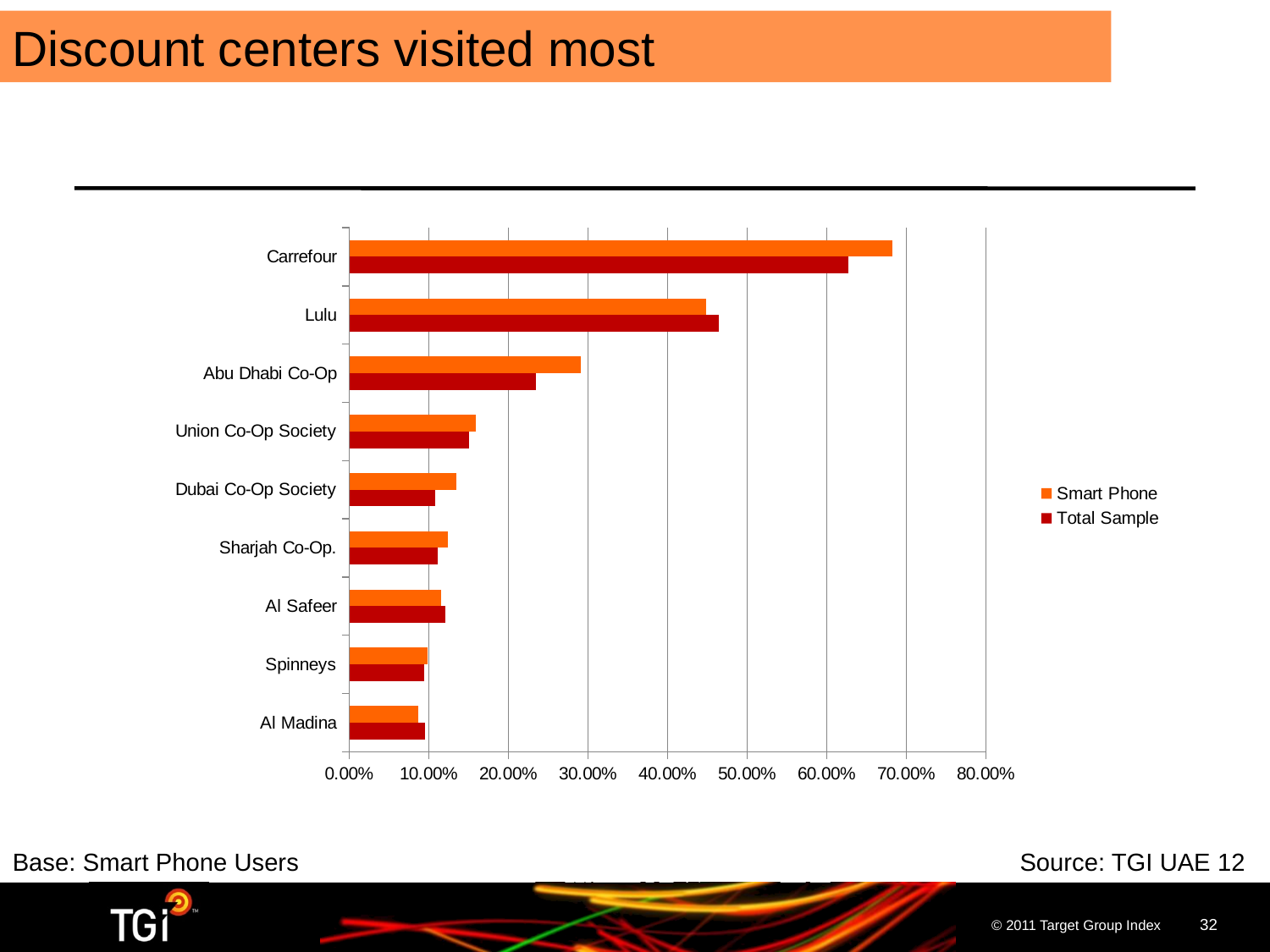
Is the Smart Phone value for Lulu greater or less than 50.00%? less Is the Smart Phone value for Carrefour greater or less than 60.00%? greater For Carrefour, which is larger: the Smart Phone value or the Total Sample value? Smart Phone How many series does the legend list? 2 What kind of chart is shown on the slide? Bar chart Which discount center has the highest Smart Phone value? Carrefour Is the Total Sample value for Abu Dhabi Co-Op greater or less than 30.00%? less What are the two series named in the legend? Smart Phone and Total Sample How many discount centers are listed on the chart? 9 Which discount center has the highest Total Sample value? Carrefour For Abu Dhabi Co-Op, which is larger: the Smart Phone value or the Total Sample value? Smart Phone